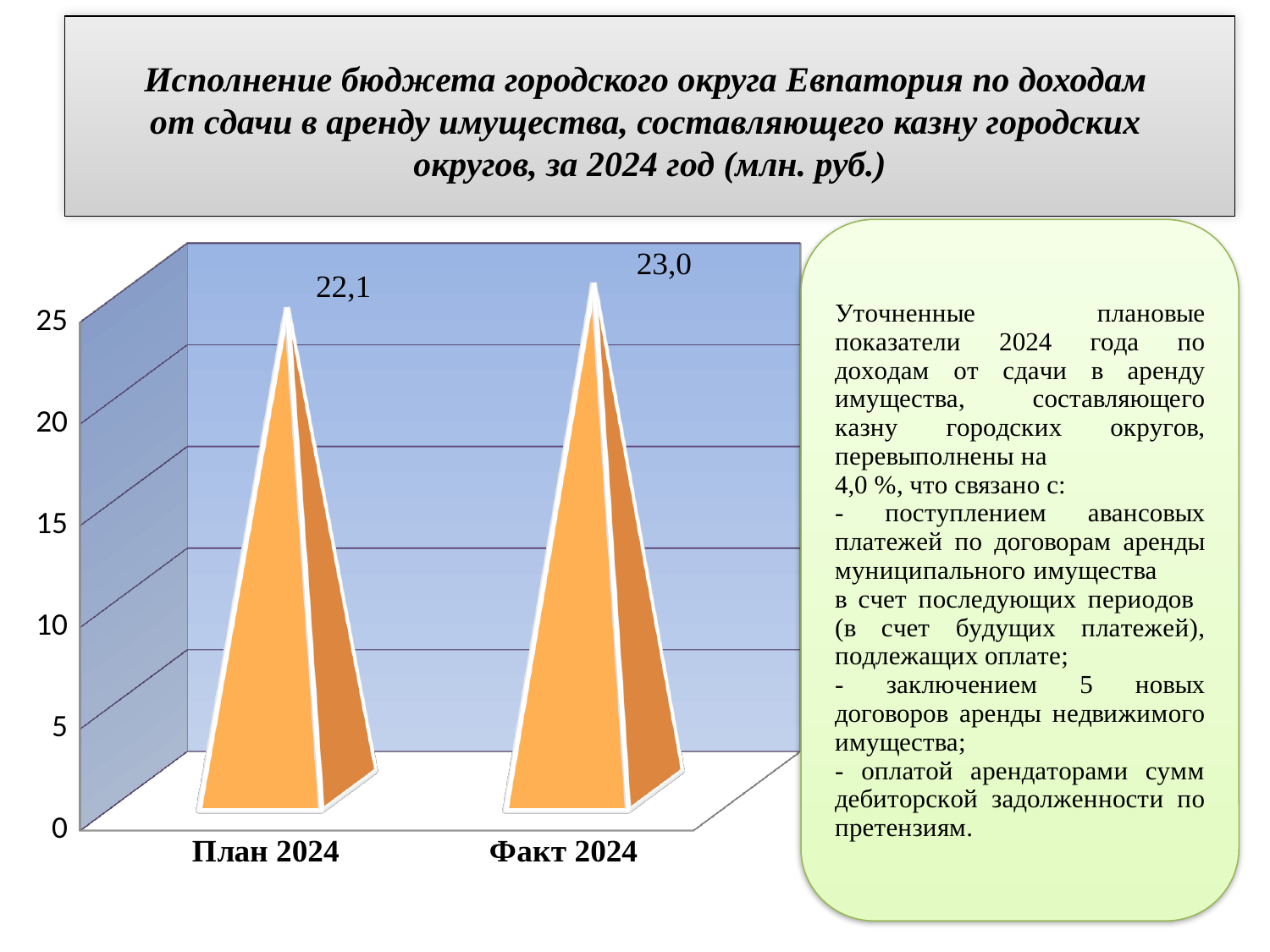
What is the difference between the values for Факт 2024 and План 2024? 0,9 Which category has the lowest value? План 2024 Do the values rise or fall from План 2024 to Факт 2024? rise Which category has the higher value, План 2024 or Факт 2024? Факт 2024 How many categories are shown on the x axis? 2 What kind of chart is shown on the slide? bar chart What is the maximum value shown on the vertical axis? 25 What is the value for План 2024? 22,1 What is the value for Факт 2024? 23,0 What unit is stated in the slide title for the chart values? млн. руб. Is the value for План 2024 greater or less than 20? greater